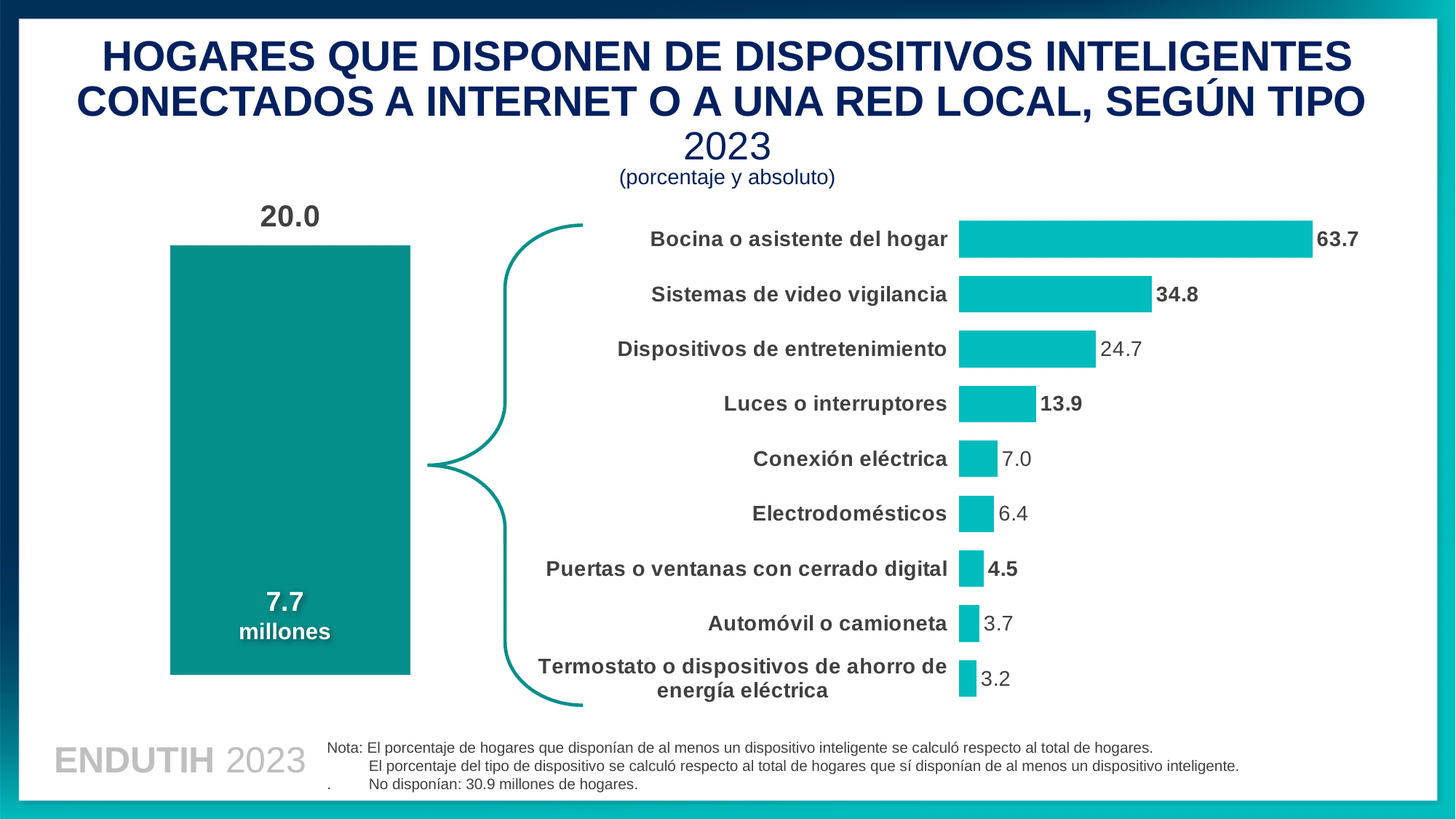
In the horizontal bar chart on the right, what is the value for Luces o interruptores? 13.9 In the horizontal bar chart on the right, what is the difference between Bocina o asistente del hogar and Sistemas de video vigilancia? 28.9 In the horizontal bar chart on the right, what is the difference between Dispositivos de entretenimiento and Luces o interruptores? 10.8 What kind of chart is shown on the right side of the slide? Bar chart How many categories does the horizontal bar chart on the right show? 9 In the single-bar chart on the left, what value is printed above the bar? 20.0 In the single-bar chart on the left, what absolute figure is printed inside the bar? 7.7 millones In the horizontal bar chart on the right, what is the value for Automóvil o camioneta? 3.7 In the horizontal bar chart on the right, which category has the highest value? Bocina o asistente del hogar In the horizontal bar chart on the right, which category has the lowest value? Termostato o dispositivos de ahorro de energía eléctrica In the horizontal bar chart on the right, what is the value for Bocina o asistente del hogar? 63.7 In the horizontal bar chart on the right, which is larger: Conexión eléctrica or Electrodomésticos? Conexión eléctrica